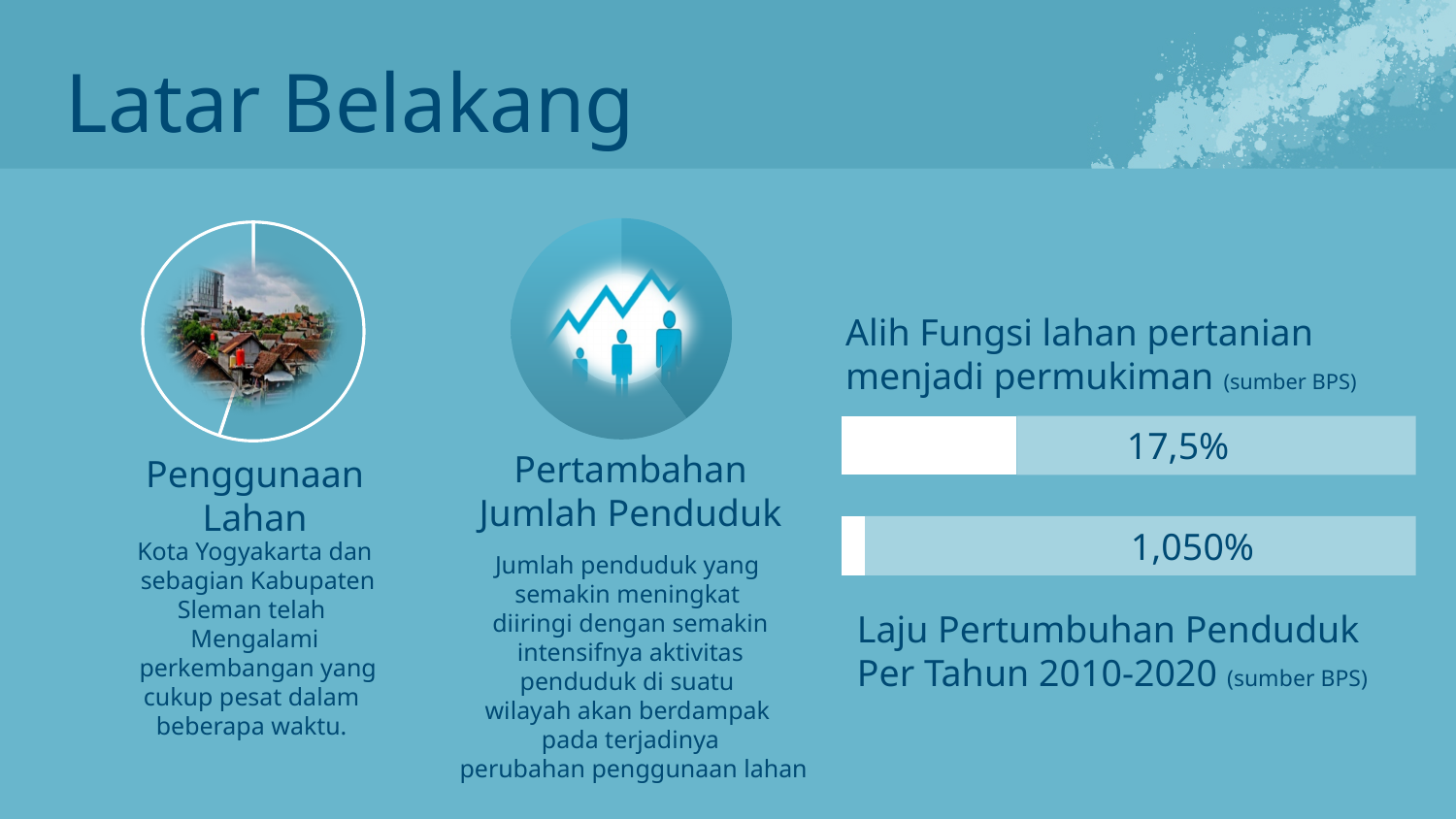
Is the value for "Laju Pertumbuhan Penduduk Per Tahun 2010-2020" greater or less than 10%? less How many bars are shown on the right side of the slide? 2 What kind of chart is used to display the 17,5% and 1,050% values on the right side of the slide? Bar chart What source is cited for the "Alih Fungsi lahan pertanian menjadi permukiman" bar? BPS What value is shown on the bar for "Alih Fungsi lahan pertanian menjadi permukiman"? 17,5% Which years does the "Laju Pertumbuhan Penduduk Per Tahun" bar cover? 2010-2020 Is the value for "Alih Fungsi lahan pertanian menjadi permukiman" greater or less than 10%? greater What value is shown on the bar for "Laju Pertumbuhan Penduduk Per Tahun 2010-2020"? 1,050% Which of the two bars on the right side of the slide shows the larger value, "Alih Fungsi lahan pertanian menjadi permukiman" or "Laju Pertumbuhan Penduduk Per Tahun 2010-2020"? Alih Fungsi lahan pertanian menjadi permukiman